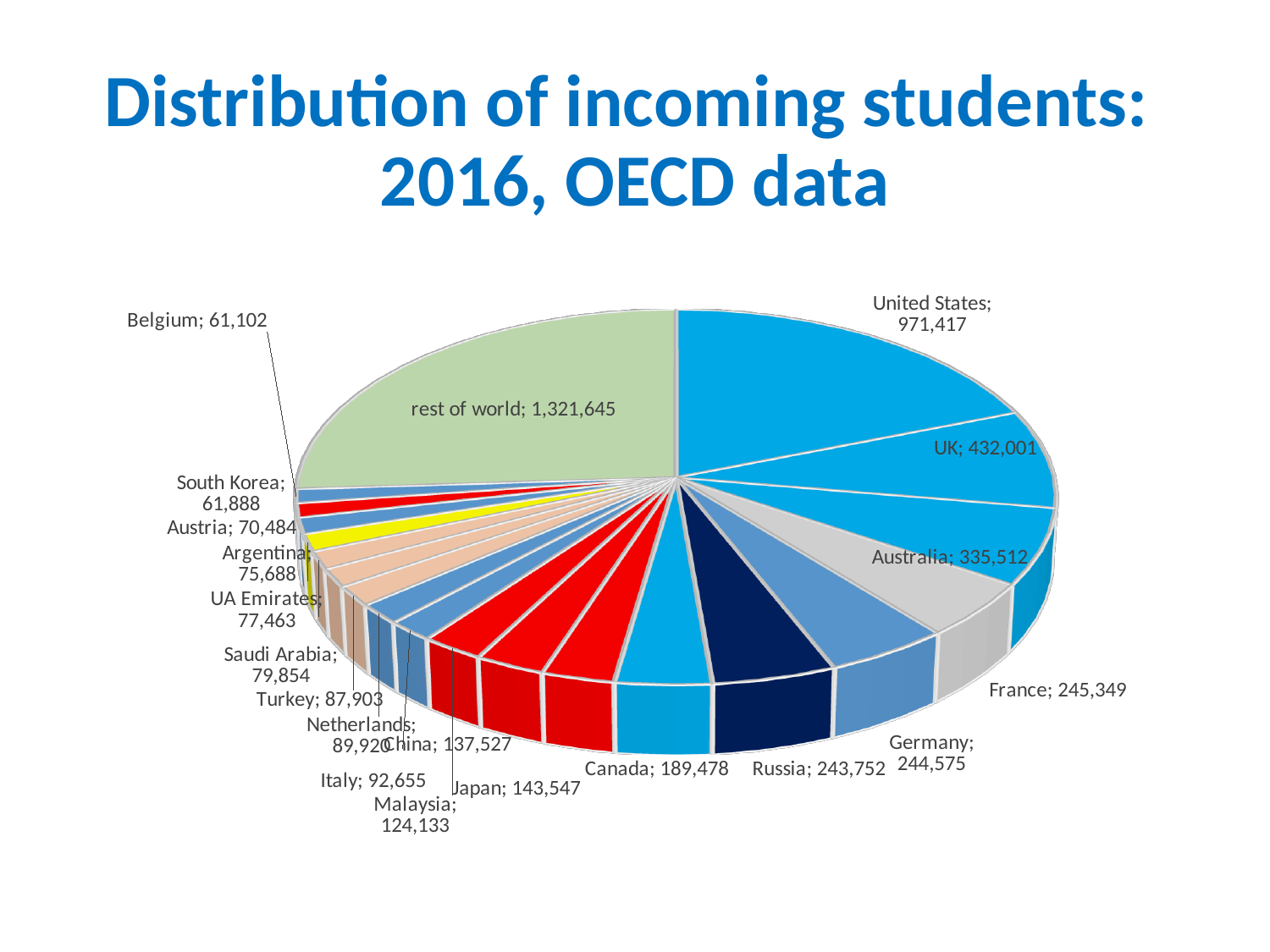
Which has the larger value, Russia or Canada? Russia What is the value shown for Malaysia? 124,133 What is the title of the chart on the slide? Distribution of incoming students: 2016, OECD data What is the value shown for the United States? 971,417 How many slices does the pie chart have? 20 What is the difference between the values for Canada and Japan? 45,931 Which slice of the pie is the largest? rest of world What kind of chart is shown on the slide? Pie chart Which slice of the pie is the smallest? Belgium What is the difference between the values for the United States and the UK? 539,416 What is the value shown for Australia? 335,512 What is the value shown for rest of world? 1,321,645